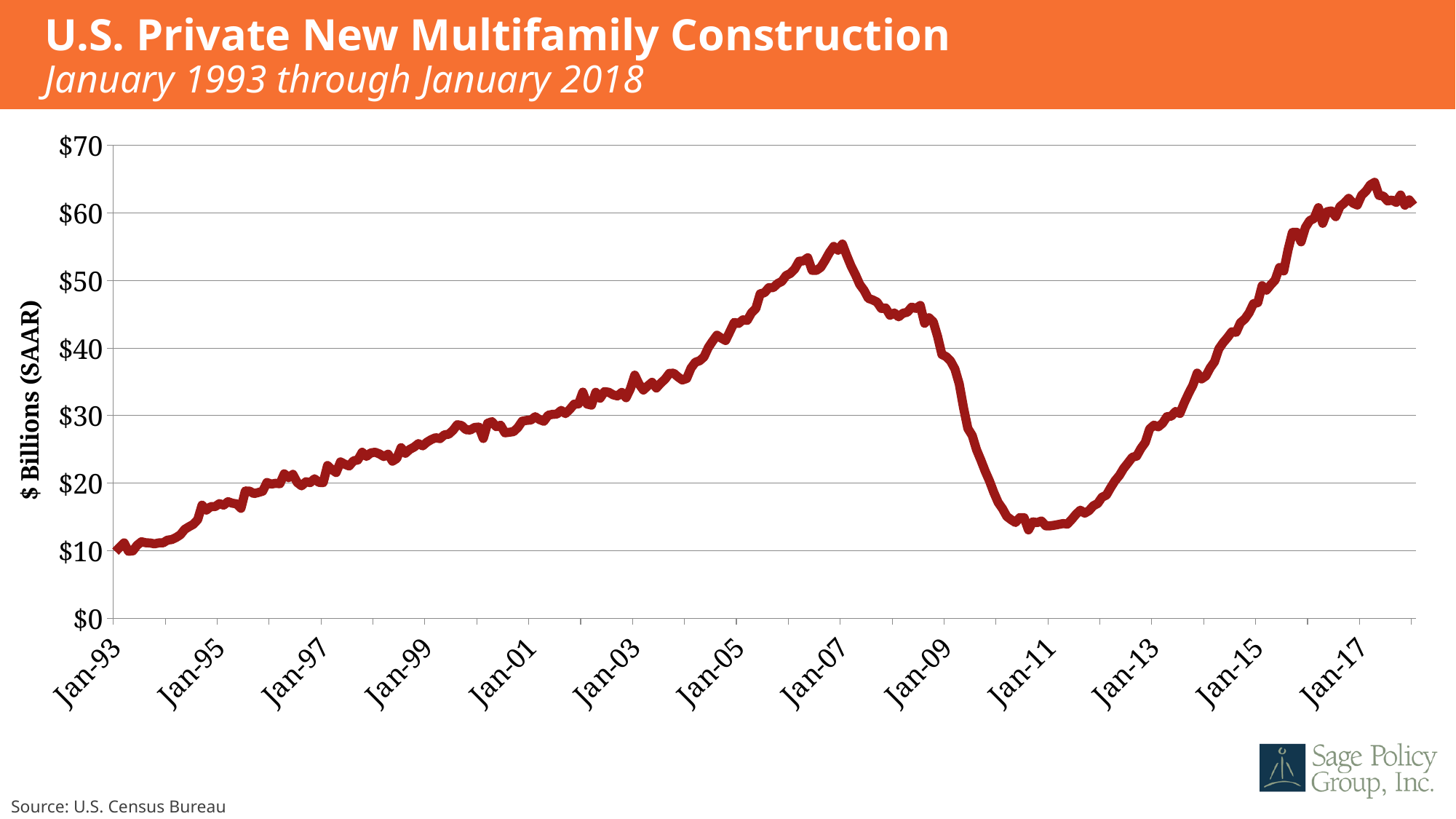
Is the value at Jan-17 greater or less than $60? greater What is the label on the vertical axis? $ Billions (SAAR) Which is larger, the value at Jan-07 or the value at Jan-17? Jan-17 Is the value at Jan-99 greater or less than $20? greater Is the value at Jan-07 greater or less than $50? greater Does the line rise or fall between Jan-11 and Jan-17? rise Does the line rise or fall between Jan-07 and Jan-11? fall What kind of chart is shown on the slide? line chart What is the title of the chart? U.S. Private New Multifamily Construction